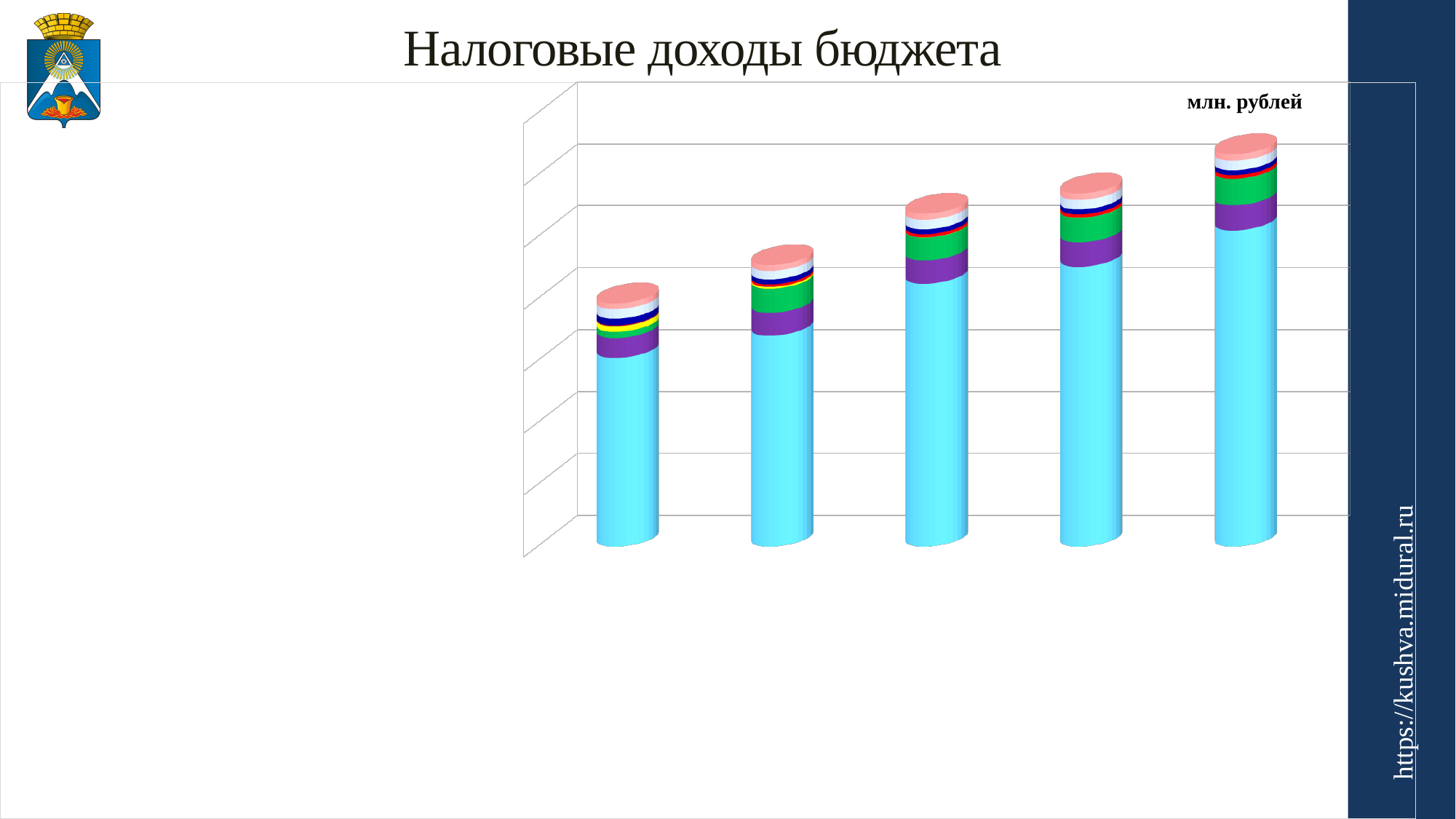
Which bar is the tallest in the chart: the leftmost or the rightmost? the rightmost What unit of measurement is indicated in the top right corner of the chart? млн. рублей What kind of chart is shown on the slide? stacked bar chart What is the title of the slide containing the chart? Налоговые доходы бюджета Do the bar heights rise or fall from left to right across the chart? rise Is the rightmost bar taller or shorter than the leftmost bar? taller How many bars are plotted in the chart? 5 Which bar is the shortest in the chart: the leftmost or the rightmost? the leftmost